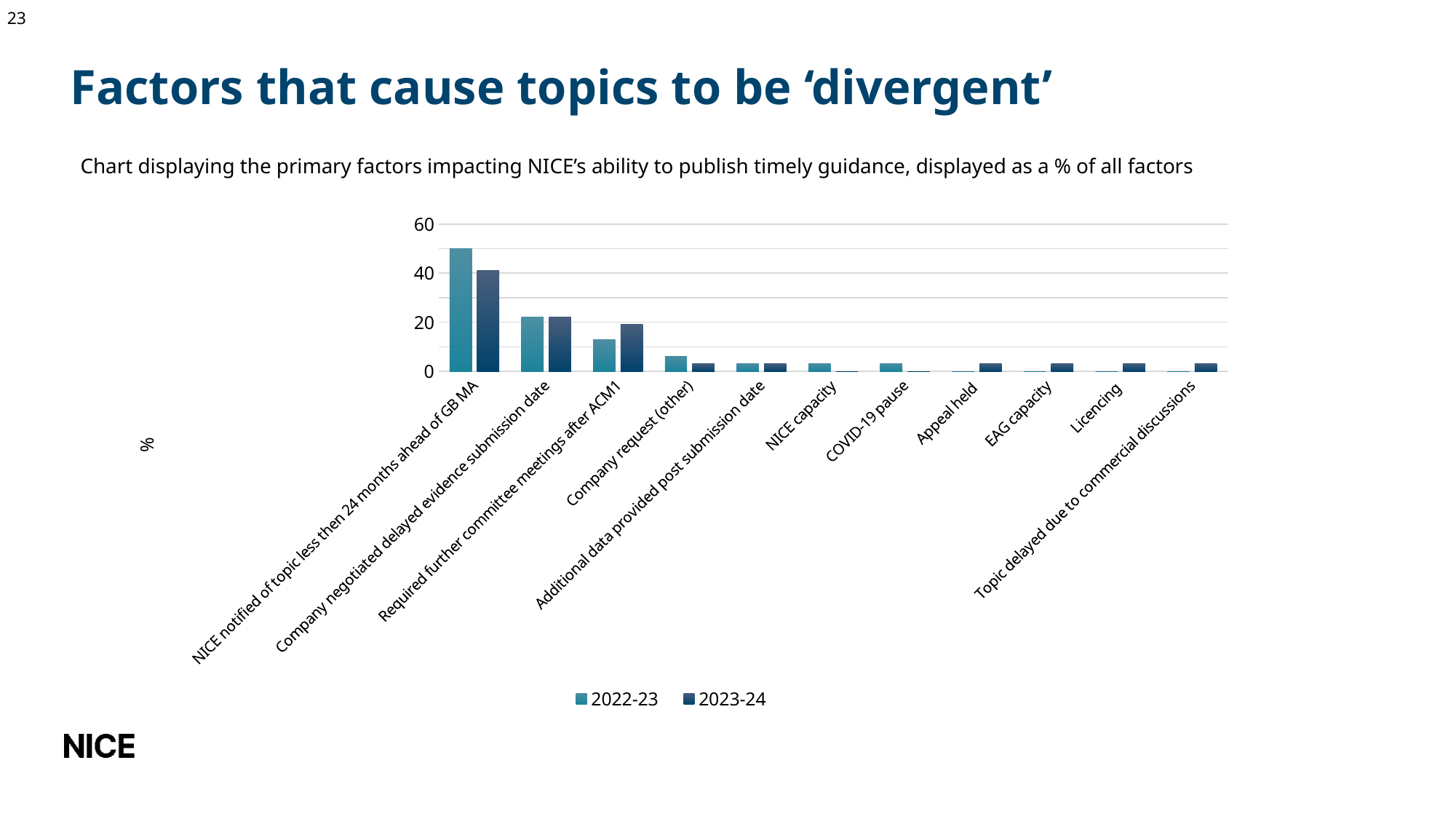
What label is shown on the vertical axis of the chart? % What kind of chart is shown on the slide? bar chart Which category has the highest value for the 2023-24 series? NICE notified of topic less then 24 months ahead of GB MA How many categories are shown on the x axis? 11 Is the 2022-23 value for 'NICE notified of topic less then 24 months ahead of GB MA' greater or less than 40? greater Do the 2022-23 values generally rise or fall moving left to right along the x axis? fall For 'NICE notified of topic less then 24 months ahead of GB MA', which series has the larger value, 2022-23 or 2023-24? 2022-23 For 'Required further committee meetings after ACM1', which series has the larger value, 2022-23 or 2023-24? 2023-24 Which category has the highest value for the 2022-23 series? NICE notified of topic less then 24 months ahead of GB MA Is the 2022-23 value for 'Company request (other)' greater or less than 20? less How many series does the legend list? 2